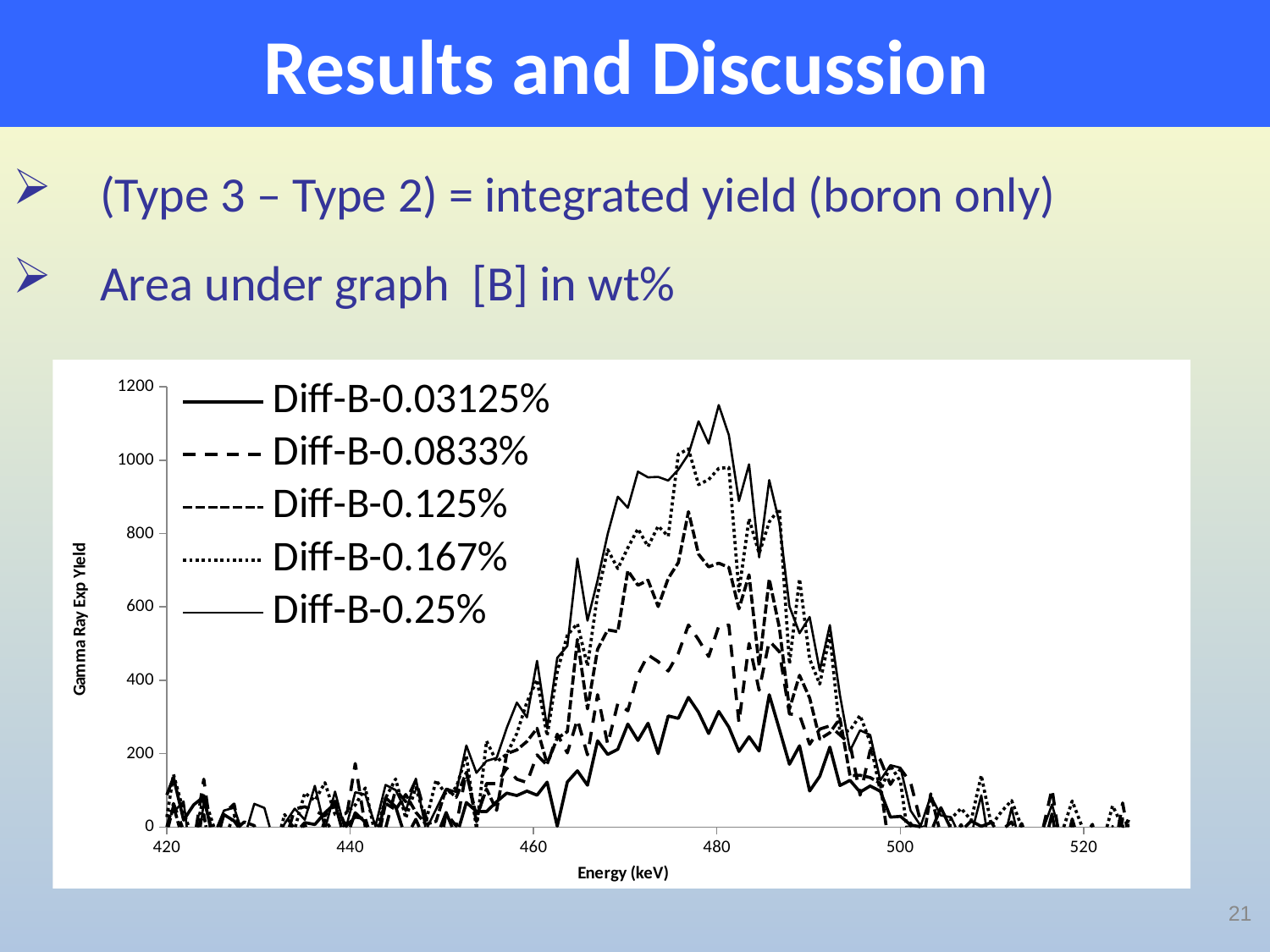
Is the peak value of the Diff-B-0.0833% series greater or less than 800? less Do the values of the Diff-B-0.25% series rise or fall between 460 keV and 480 keV? rise What kind of chart is shown on the slide? line chart Which series has the lowest peak value? Diff-B-0.03125% Which series has a higher peak, Diff-B-0.167% or Diff-B-0.0833%? Diff-B-0.167% What is the title of the x axis? Energy (keV) Do the values of the Diff-B-0.25% series rise or fall between 480 keV and 500 keV? fall How many series does the legend list? 5 Is the peak value of the Diff-B-0.03125% series greater or less than 400? less What is the title of the y axis? Gamma Ray Exp Yield Is the peak value of the Diff-B-0.25% series greater or less than 1000? greater Which series reaches the highest peak value? Diff-B-0.25%